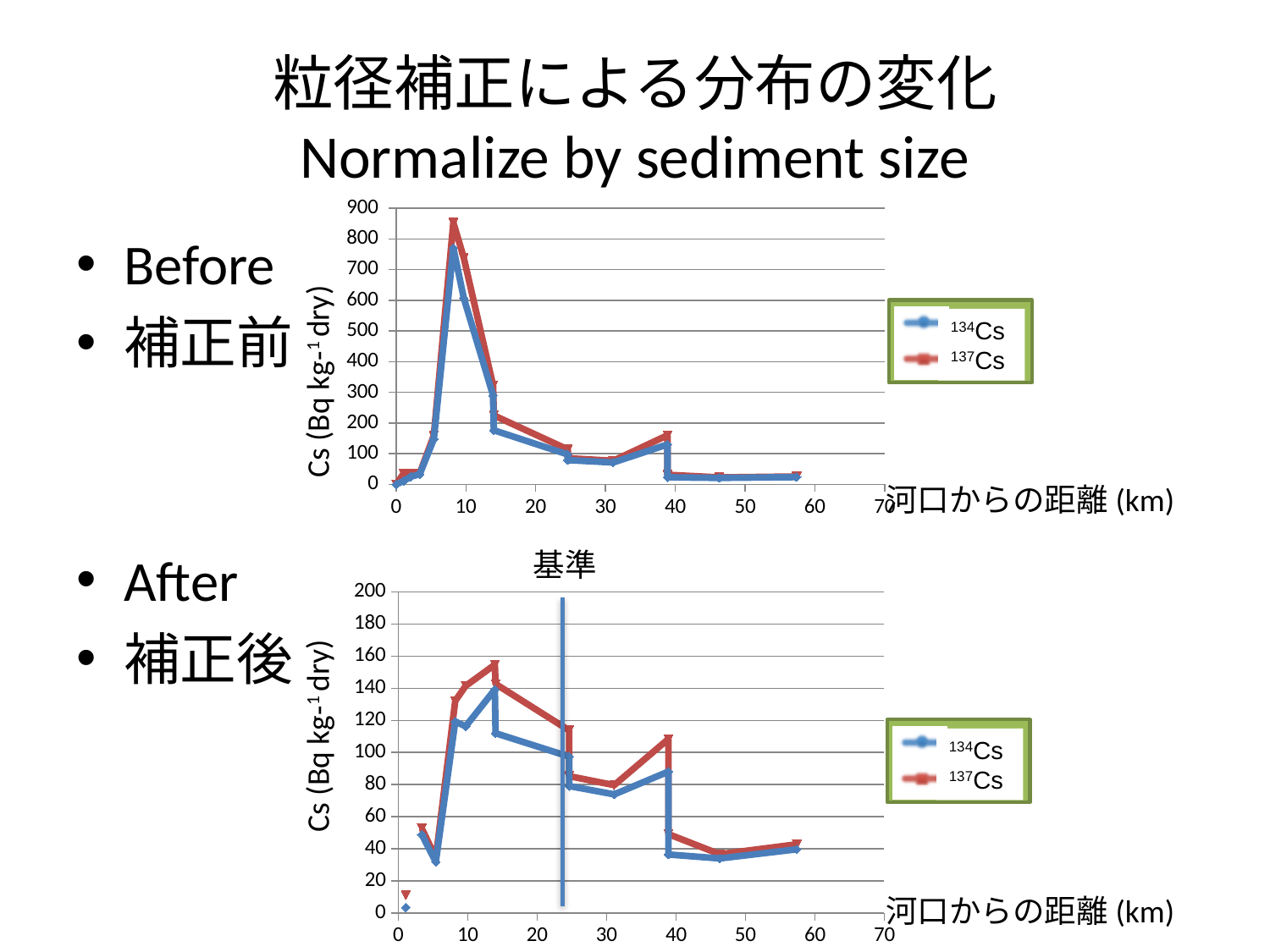
What is the y-axis label of the top chart? Cs (Bq kg-1 dry) In the top chart, which series reaches the highest value? 137Cs What kind of chart is the top chart (Before / 補正前)? line chart In the top chart, is the peak value of the 134Cs series greater or less than 700? greater How many series does the legend of the top chart list? 2 In the bottom chart, which series is shown in red? 137Cs In the bottom chart, is the 134Cs value at about 31 km greater or less than 80? less In the top chart, is the peak value of the 137Cs series greater or less than 800? greater In the top chart, do the values rise or fall along the x axis between 10 km and 30 km? fall What kind of chart is the bottom chart (After / 補正後)? line chart In the bottom chart, at about 39 km, which series has the larger value, 134Cs or 137Cs? 137Cs